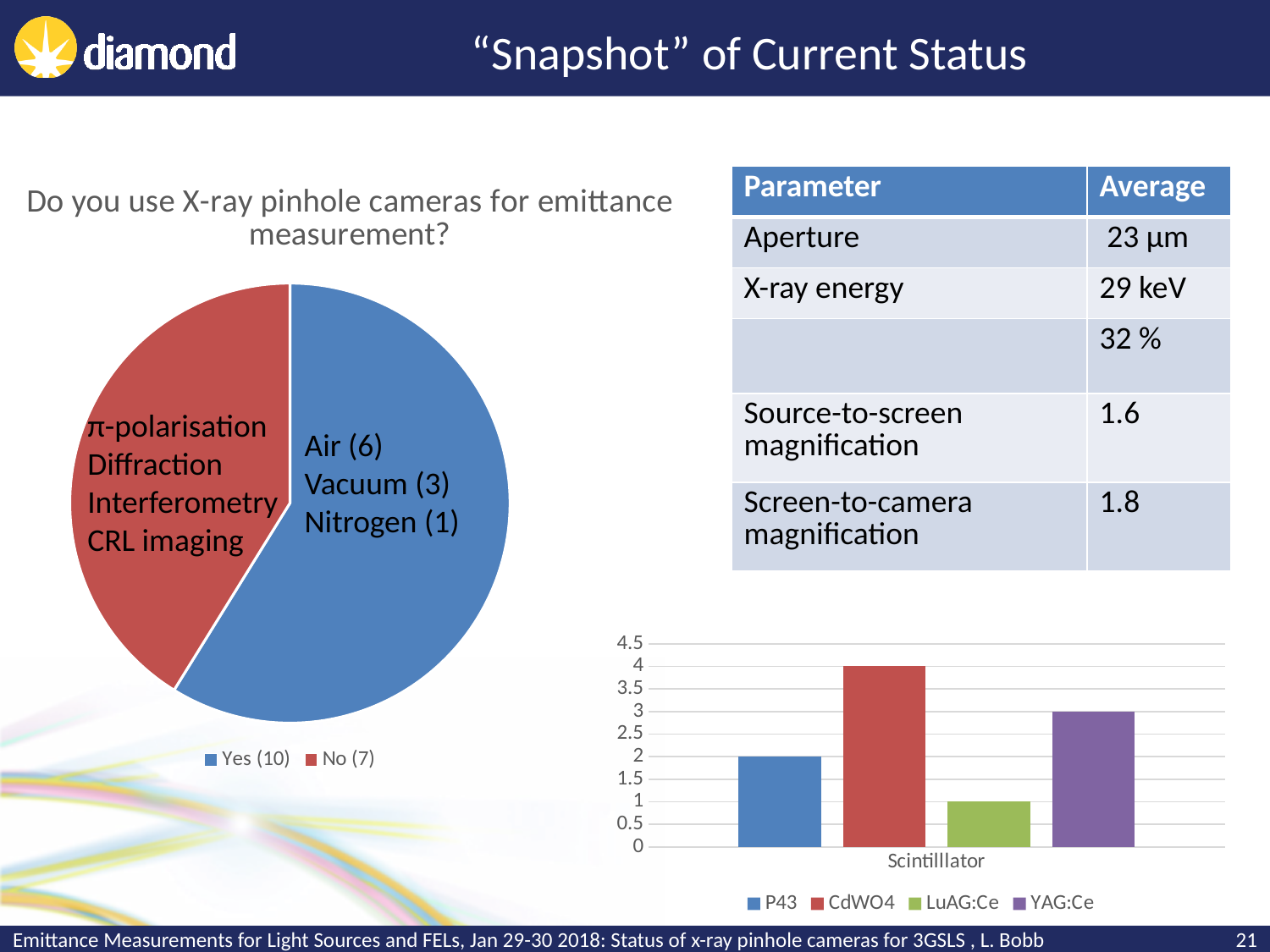
In the bar chart at the bottom right, which scintillator has the lowest value? LuAG:Ce In the bar chart at the bottom right, how many series does the legend list? 4 In the bar chart at the bottom right, which scintillator has the highest value? CdWO4 What is the title of the pie chart? Do you use X-ray pinhole cameras for emittance measurement? What kind of chart is shown at the bottom right of the slide? Bar chart In the pie chart, how many slices are there? 2 In the bar chart at the bottom right, what is the value for CdWO4? 4 In the pie chart, which response has the larger slice, Yes or No? Yes In the pie chart, how many respondents answered No? 7 In the bar chart at the bottom right, what is the value for P43? 2 In the pie chart, what is the difference between the number of Yes and No responses? 3 In the pie chart, how many respondents answered Yes? 10